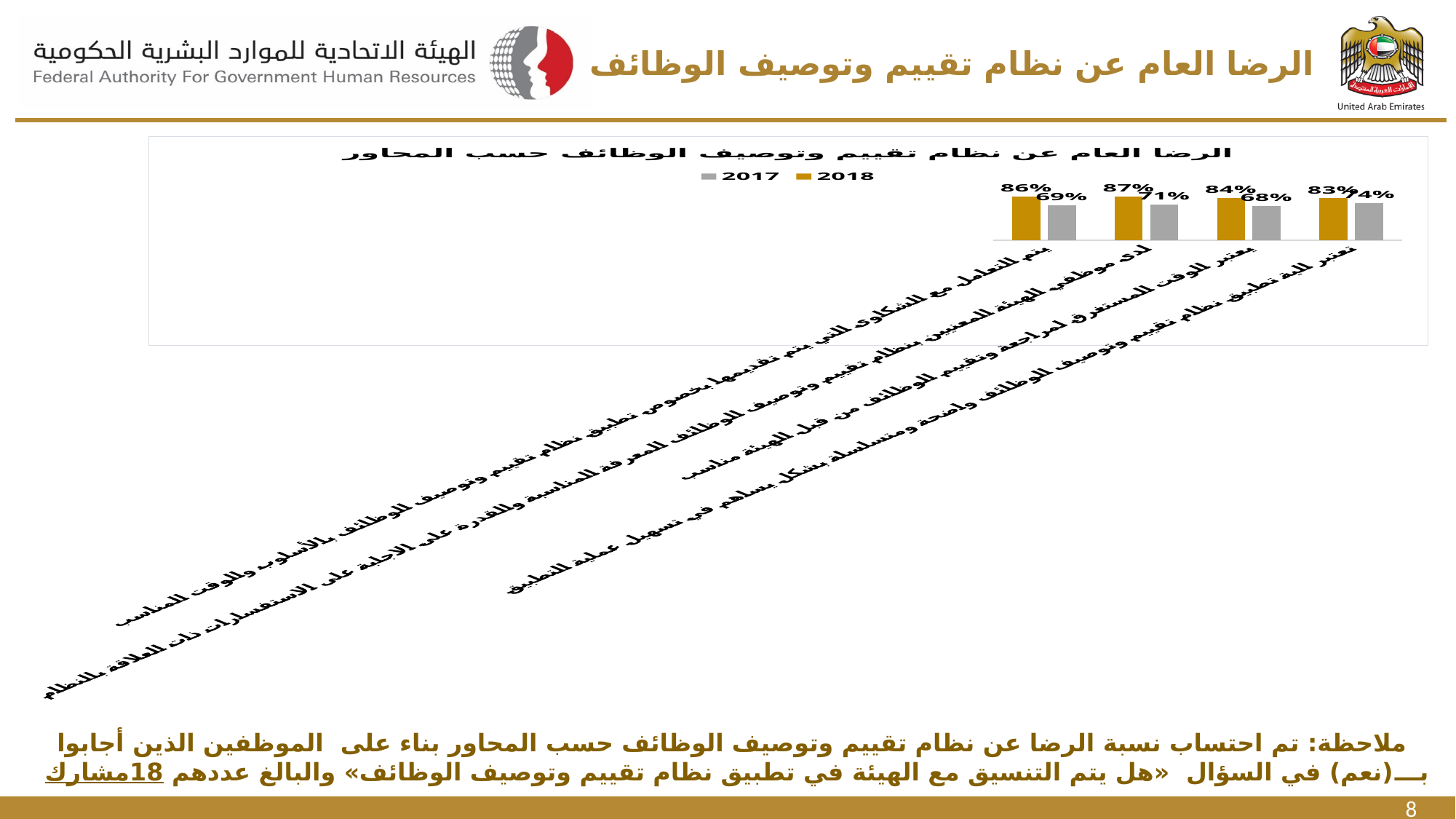
What is the 2018 value for the leftmost category (يتم التعامل مع الشكاوى التي يتم تقديمها...)? 86% For the rightmost category (تعتبر آلية تطبيق نظام تقييم وتوصيف الوظائف...), which year has the larger value, 2017 or 2018? 2018 What is the 2017 value for the category 'يعتبر الوقت المستغرق لمراجعة وتقييم الوظائف من قبل الهيئة مناسب'? 68% What is the title of the chart? الرضا العام عن نظام تقييم وتوصيف الوظائف حسب المحاور How many categories (groups of bars) are plotted in the chart? 4 What is the difference between the 2018 and 2017 values for the leftmost category (يتم التعامل مع الشكاوى...)? 17 percentage points What is the 2017 value for the rightmost category (تعتبر آلية تطبيق نظام تقييم وتوصيف الوظائف واضحة ومتسلسلة...)? 74% Which category has the highest 2018 value? لدى موظفي الهيئة المعنيين بنظام تقييم وتوصيف الوظائف المعرفة المناسبة والقدرة على الاجابة على الاستفسارات ذات العلاقة بالنظام (87%) Which category has the lowest 2017 value? يعتبر الوقت المستغرق لمراجعة وتقييم الوظائف من قبل الهيئة مناسب (68%) How many series does the chart legend list? 2 What colour represents the 2018 series in the chart? Gold/orange What type of chart is shown on the slide? Bar chart